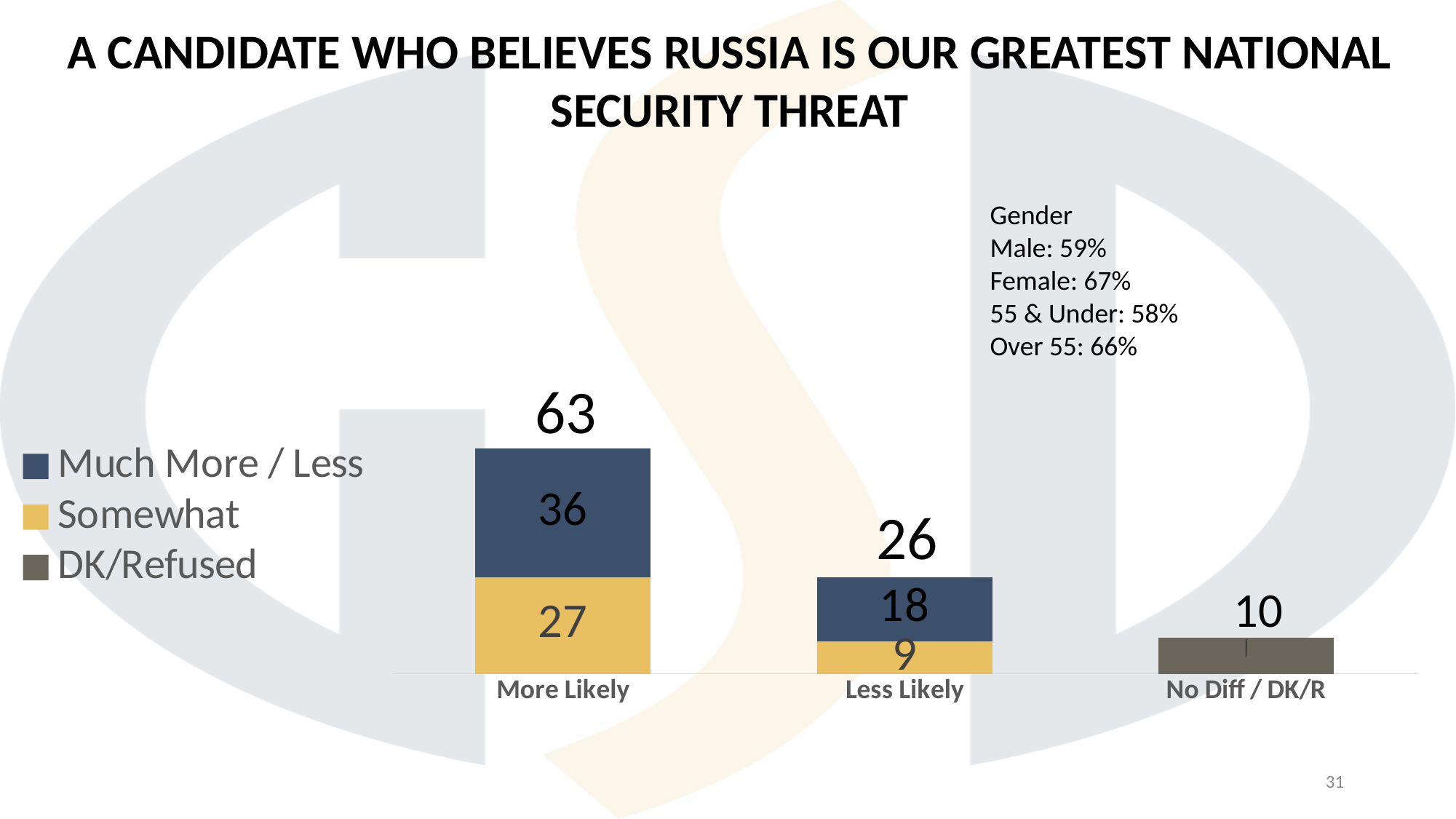
Which is larger: the Much More / Less value for More Likely or for Less Likely? More Likely What is the Somewhat value for Less Likely? 9 What is the Much More / Less value for Less Likely? 18 Which category has the lowest total? No Diff / DK/R Which category has the highest total? More Likely What kind of chart is shown? Stacked bar chart What is the total value of the More Likely bar? 63 How many series does the legend list? 3 What is the difference between the totals for More Likely and Less Likely? 37 What is the Somewhat value for More Likely? 27 How many categories are shown on the x axis? 3 What is the value for No Diff / DK/R? 10